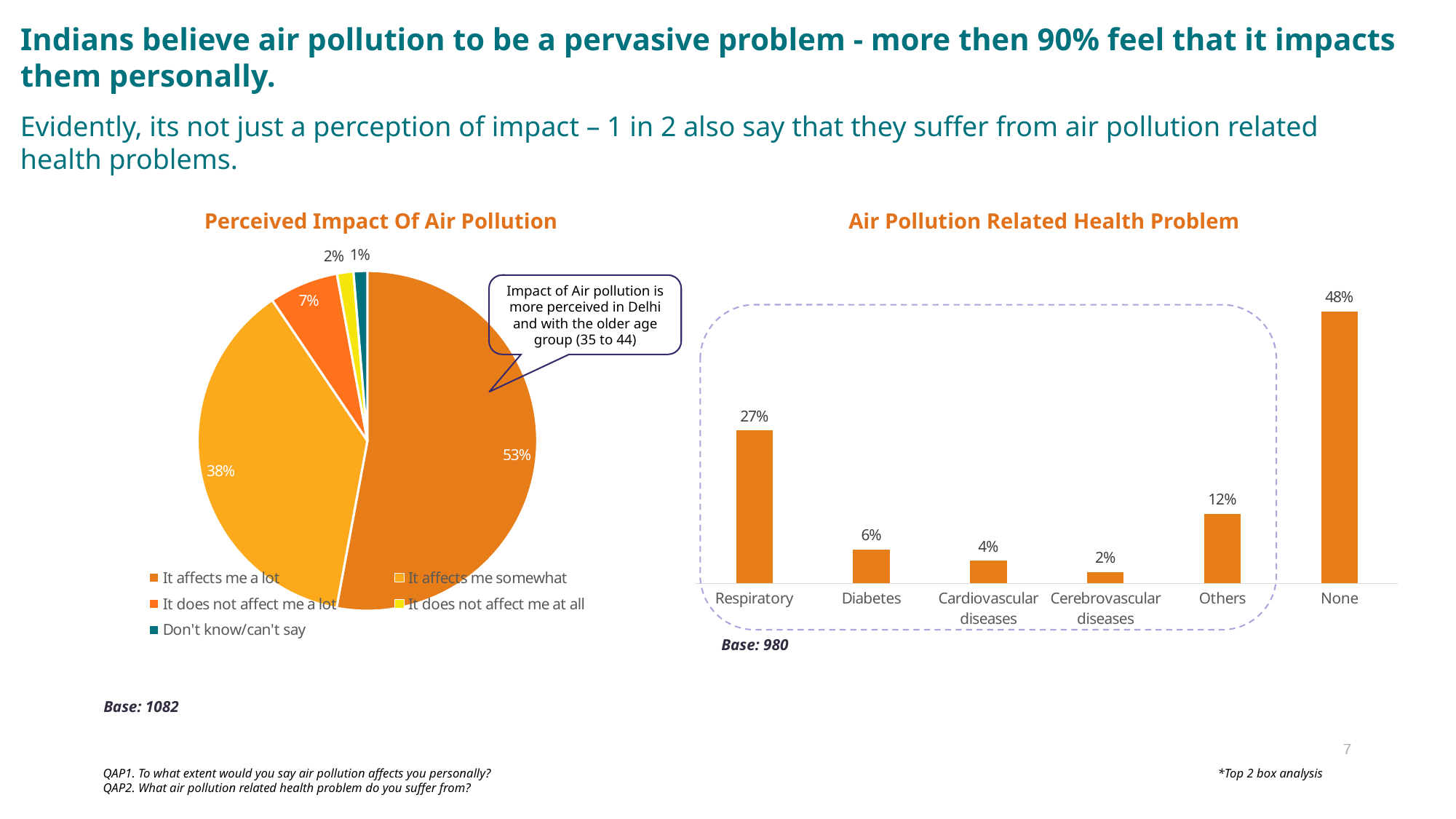
How many entries does the legend of the 'Perceived Impact Of Air Pollution' chart list? 5 In the 'Perceived Impact Of Air Pollution' chart, what percentage say 'It does not affect me a lot'? 7% In the 'Perceived Impact Of Air Pollution' chart, what percentage say 'It affects me somewhat'? 38% What kind of chart is 'Perceived Impact Of Air Pollution'? Pie chart In the 'Perceived Impact Of Air Pollution' chart, which response has the smallest slice? Don't know/can't say In the 'Air Pollution Related Health Problem' chart, what is the value for Respiratory? 27% In the 'Air Pollution Related Health Problem' chart, what is the difference between Respiratory and Others? 15% How many categories are shown in the 'Air Pollution Related Health Problem' chart? 6 In the 'Perceived Impact Of Air Pollution' chart, what share of respondents say 'It affects me a lot'? 53% In the 'Air Pollution Related Health Problem' chart, which is larger, Diabetes or Cardiovascular diseases? Diabetes In the 'Air Pollution Related Health Problem' chart, which category has the highest value? None In the 'Air Pollution Related Health Problem' chart, which category has the lowest value? Cerebrovascular diseases